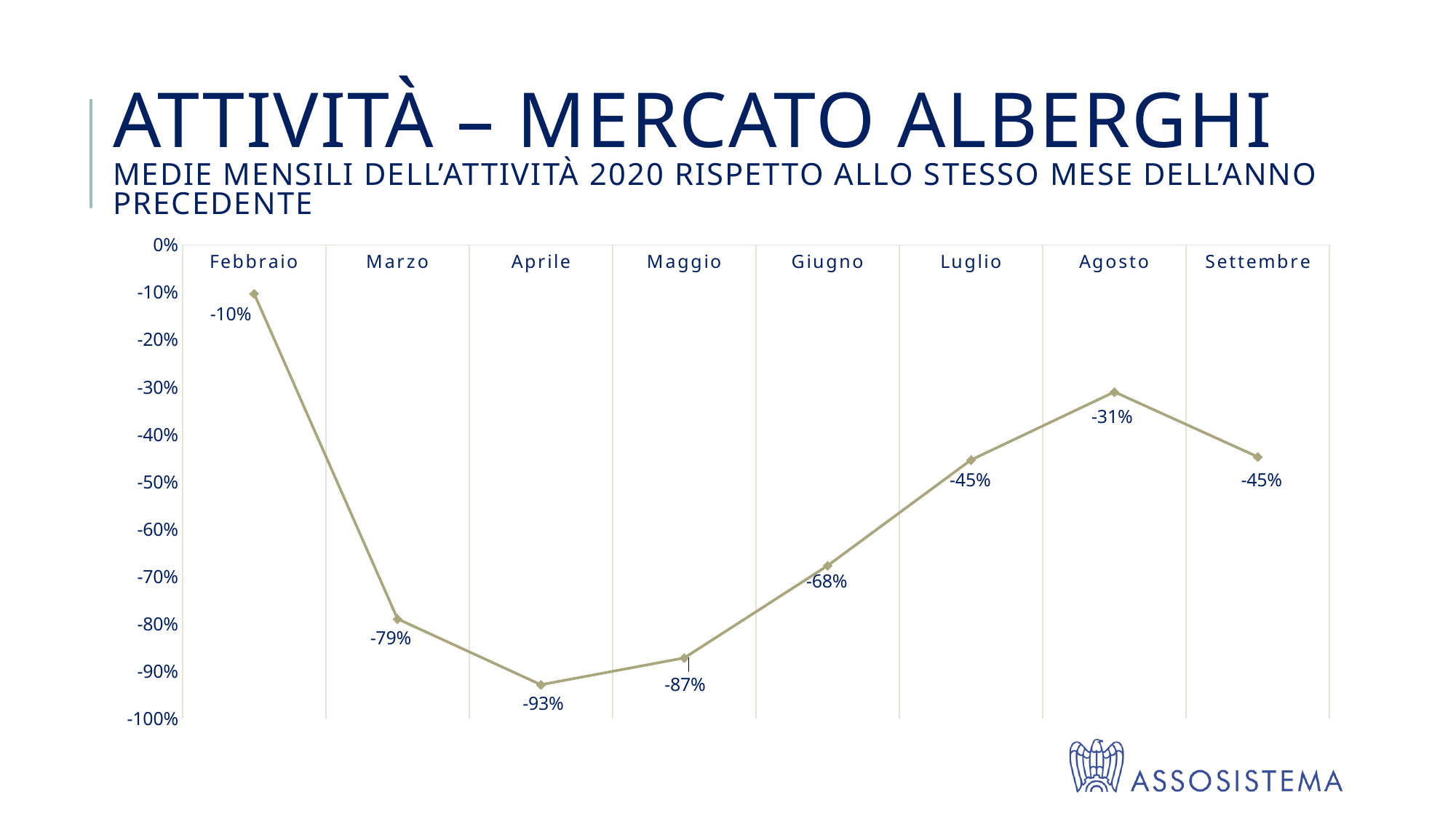
What kind of chart is shown on the slide? Line chart What is the value for Aprile? -93% Do the values rise or fall from Febbraio to Aprile? Fall Which is larger, the value for Maggio or the value for Giugno? Giugno What is the difference between the values for Marzo and Aprile? 14 percentage points How many months are plotted on the chart? 8 Which month has the lowest value? Aprile Do the values rise or fall from Aprile to Agosto? Rise Which month has the highest value? Febbraio What is the value for Giugno? -68% What is the title of the slide? ATTIVITÀ – MERCATO ALBERGHI What is the value for Agosto? -31%